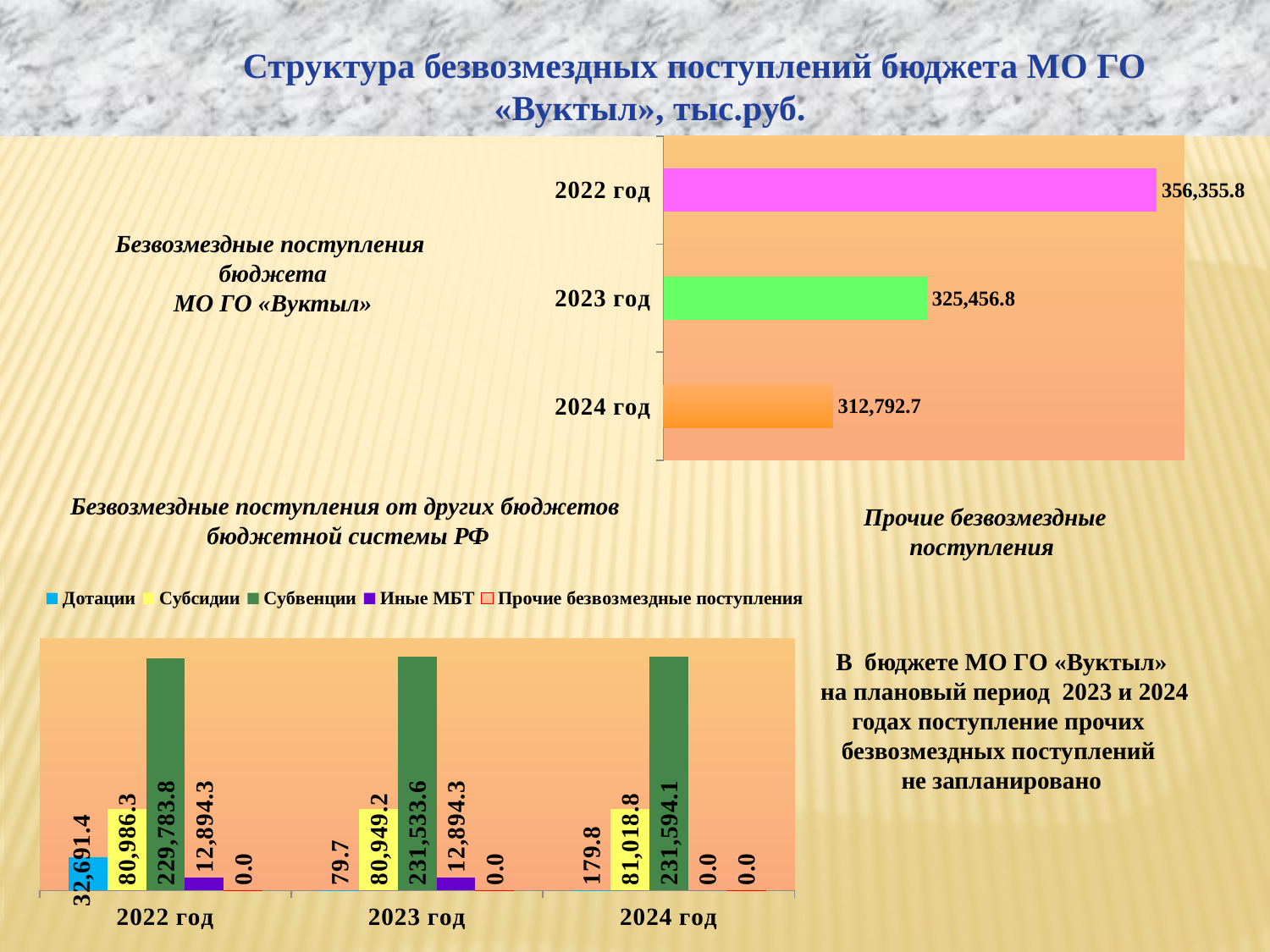
In the top-right bar chart, which year has the lowest value? 2024 год What kind of chart is the top-right chart? bar chart In the top-right bar chart, do the values rise or fall from 2022 год to 2024 год? fall In the top-right bar chart, what is the value for 2024 год? 312,792.7 In the bottom-left bar chart, what is the value of Дотации for 2022 год? 32,691.4 In the bottom-left bar chart, what is the value of Субвенции for 2024 год? 231,594.1 In the top-right bar chart, which year has the highest value? 2022 год In the bottom-left bar chart, what is the value of Иные МБТ for 2024 год? 0.0 In the top-right bar chart, what is the difference between the values for 2022 год and 2023 год? 30,899.0 In the bottom-left bar chart, which is larger: Субсидии for 2022 год or Субсидии for 2024 год? Субсидии for 2024 год In the top-right bar chart (Безвозмездные поступления бюджета МО ГО «Вуктыл»), what is the value for 2022 год? 356,355.8 How many series does the legend of the bottom-left bar chart list? 5